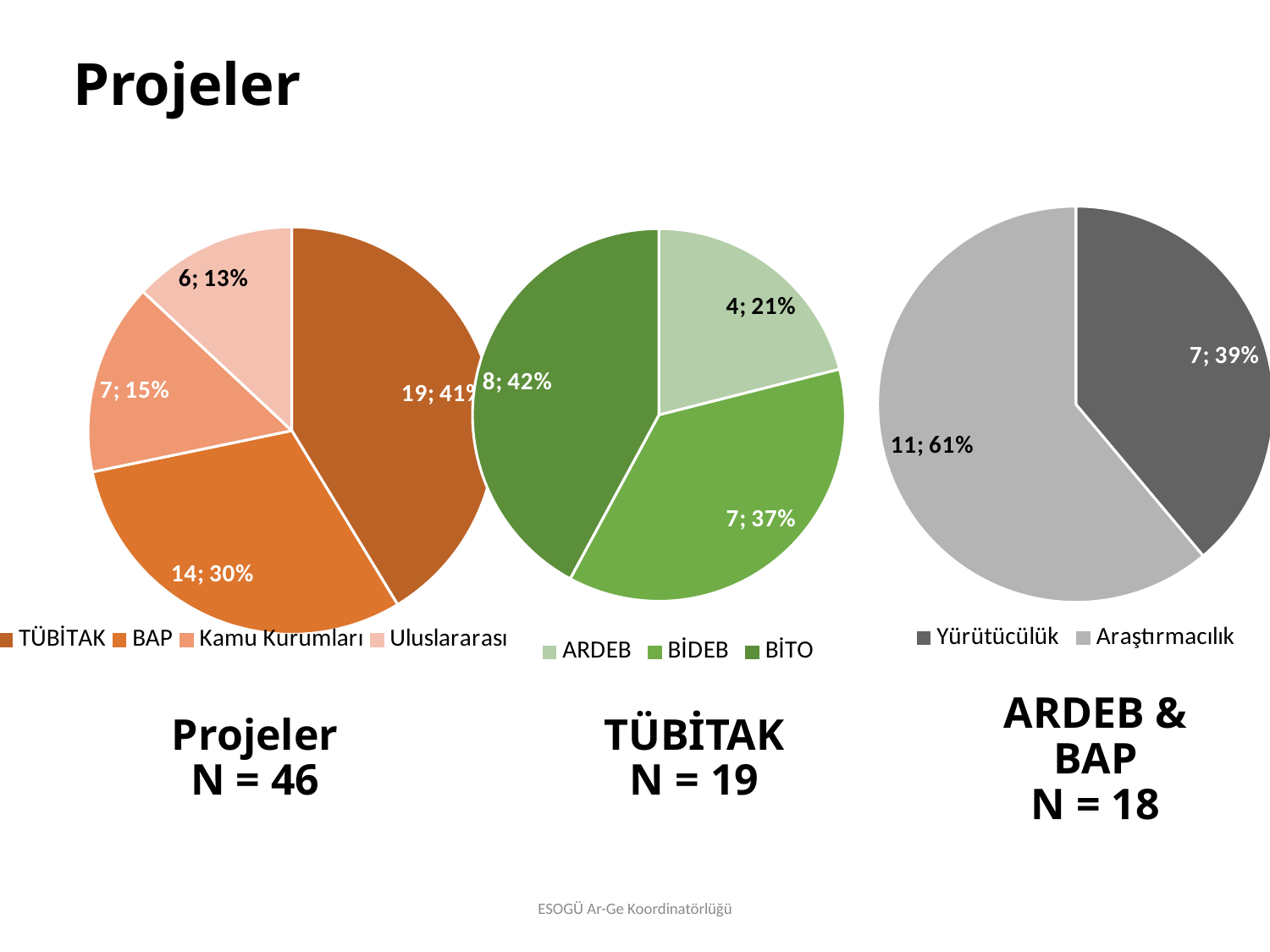
In the left pie chart (Projeler, N = 46), which category has the smallest slice? Uluslararası In the middle pie chart (TÜBİTAK, N = 19), which is larger, ARDEB or BİDEB? BİDEB How many categories does the left pie chart (Projeler, N = 46) show? 4 In the middle pie chart (TÜBİTAK, N = 19), how many projects are in BİTO? 8 In the left pie chart (Projeler, N = 46), what is the difference between the TÜBİTAK count and the BAP count? 5 What type of chart is used for the three charts on the slide? Pie chart In the right pie chart (ARDEB & BAP, N = 18), what share does Yürütücülük hold? 39% In the left pie chart (Projeler, N = 46), what share of the pie does Uluslararası hold? 13% In the middle pie chart (TÜBİTAK, N = 19), what percentage share does BİDEB have? 37% In the left pie chart (Projeler, N = 46), which category has the largest slice? TÜBİTAK In the left pie chart (Projeler, N = 46), how many projects are in the BAP category? 14 In the right pie chart (ARDEB & BAP, N = 18), how many projects are Araştırmacılık? 11